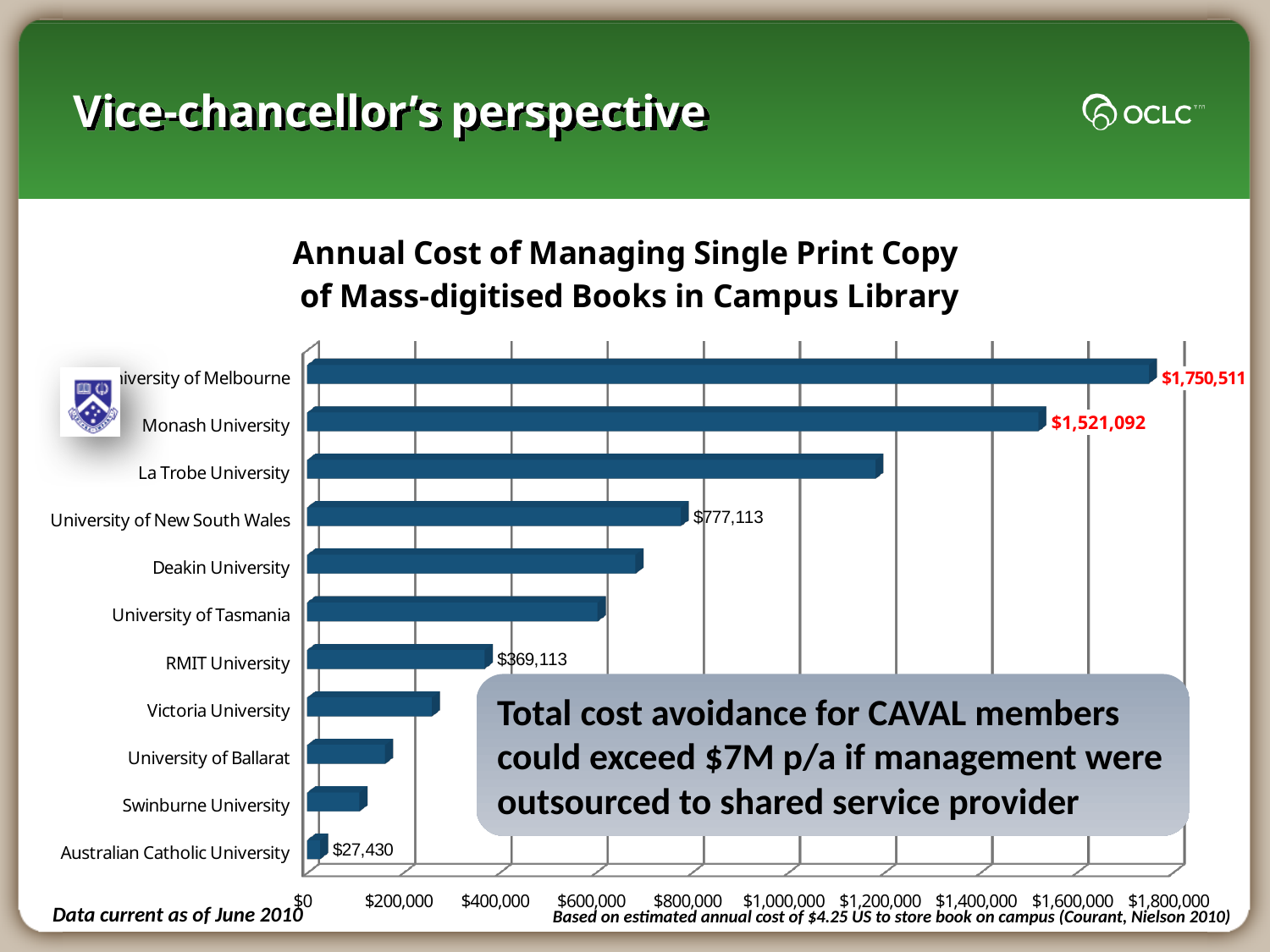
What is the annual cost shown for Monash University? $1,521,092 Is the value for Deakin University greater or less than $600,000? greater What is the difference between the annual cost for the University of Melbourne and Monash University? $229,419 How many universities are listed on the chart? 11 What is the annual cost shown for RMIT University? $369,113 Which university has the highest annual cost on the chart? University of Melbourne What is the annual cost shown for the University of Melbourne? $1,750,511 What is the annual cost shown for Australian Catholic University? $27,430 Which university has the lowest annual cost on the chart? Australian Catholic University What kind of chart is shown on the slide? bar chart What is the annual cost shown for the University of New South Wales? $777,113 Is the value for University of Ballarat greater or less than $200,000? less